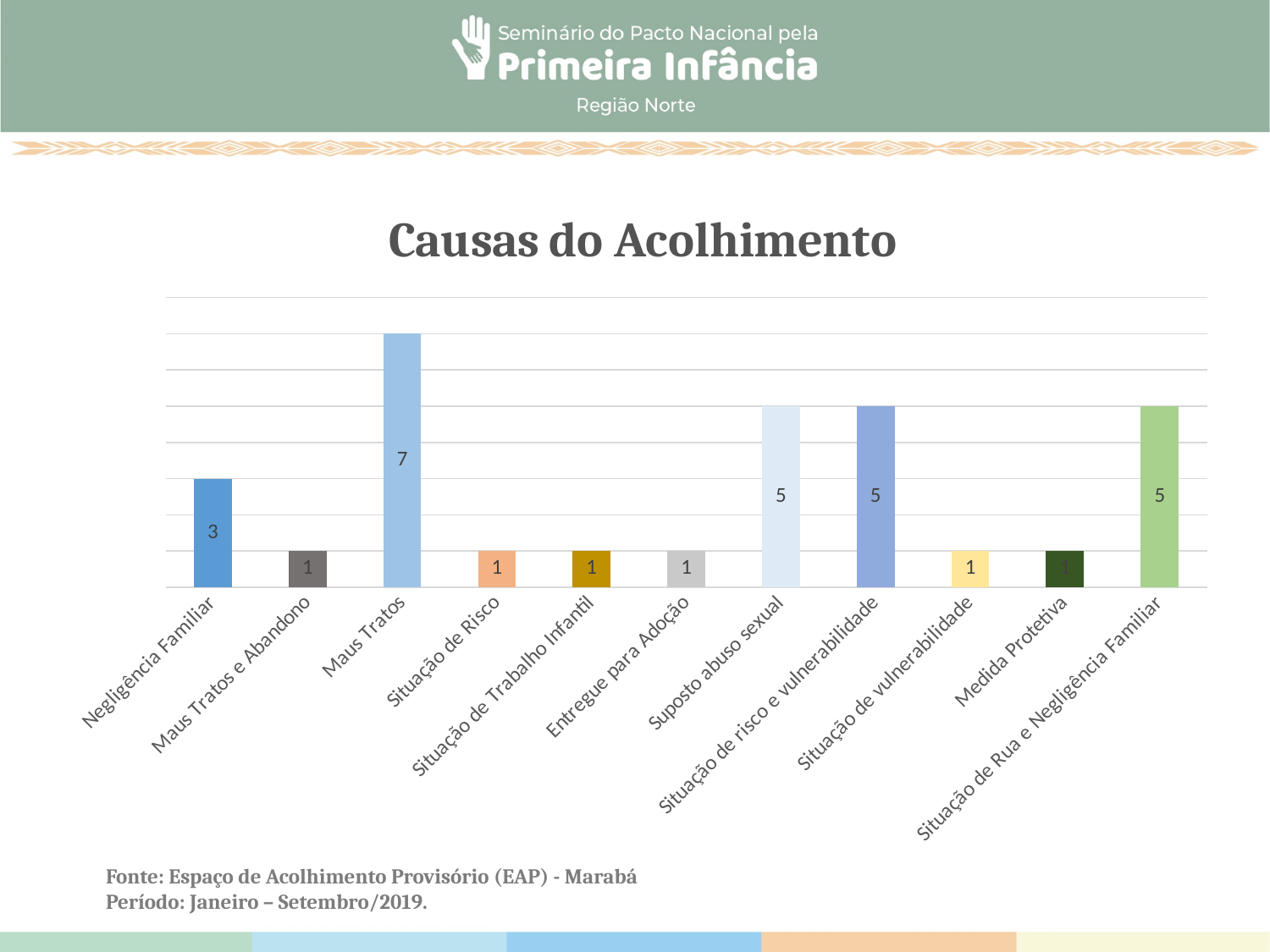
What is the difference between the values for Maus Tratos and Negligência Familiar? 4 What kind of chart is shown on the slide? Bar chart Which category has the highest value? Maus Tratos What is the value for Suposto abuso sexual? 5 Which is larger, the value for Negligência Familiar or the value for Situação de Rua e Negligência Familiar? Situação de Rua e Negligência Familiar What is the difference between the values for Situação de risco e vulnerabilidade and Situação de vulnerabilidade? 4 How many categories have a value of 1? 6 How many categories are shown on the x axis? 11 What is the value for Negligência Familiar? 3 What is the value for Medida Protetiva? 1 What is the value for Maus Tratos? 7 What is the title of the chart? Causas do Acolhimento